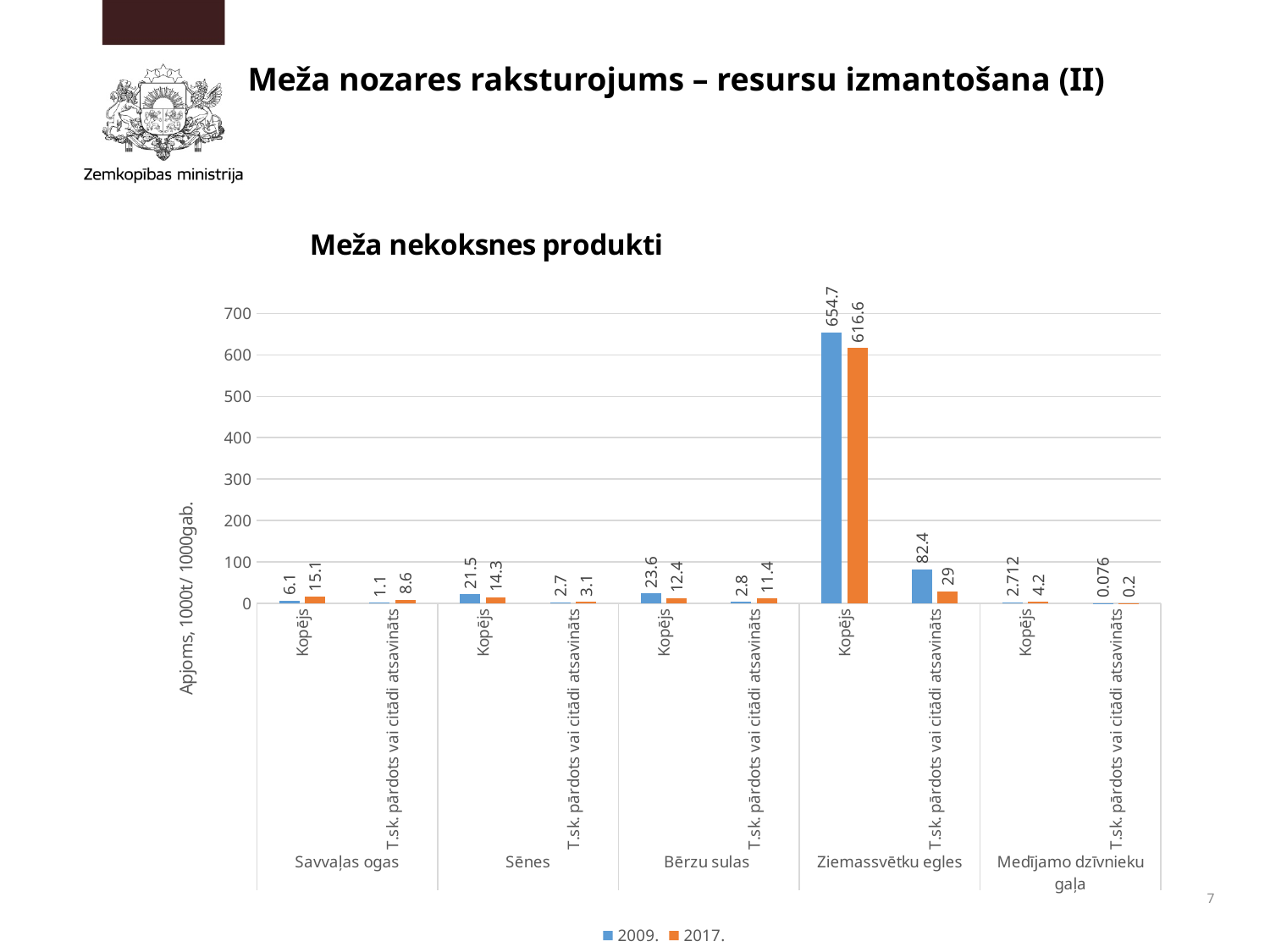
What type of chart is shown on the slide? bar chart What is the 2017. value for Savvaļas ogas, Kopējs? 15.1 Is the 2017. value for Ziemassvētku egles, Kopējs greater or less than 600? greater Which product group has the highest 2017. Kopējs value? Ziemassvētku egles How many series does the legend list? 2 Which product group has the lowest 2009. Kopējs value? Medījamo dzīvnieku gaļa For Bērzu sulas, Kopējs, which is larger: the 2009. value or the 2017. value? 2009. What is the 2017. value for Medījamo dzīvnieku gaļa, T.sk. pārdots vai citādi atsavināts? 0.2 What is the difference between the 2009. and 2017. values for Ziemassvētku egles, Kopējs? 38.1 What is the 2009. value for Ziemassvētku egles, Kopējs? 654.7 What is the title of the chart? Meža nekoksnes produkti How many product groups are shown on the x axis? 5